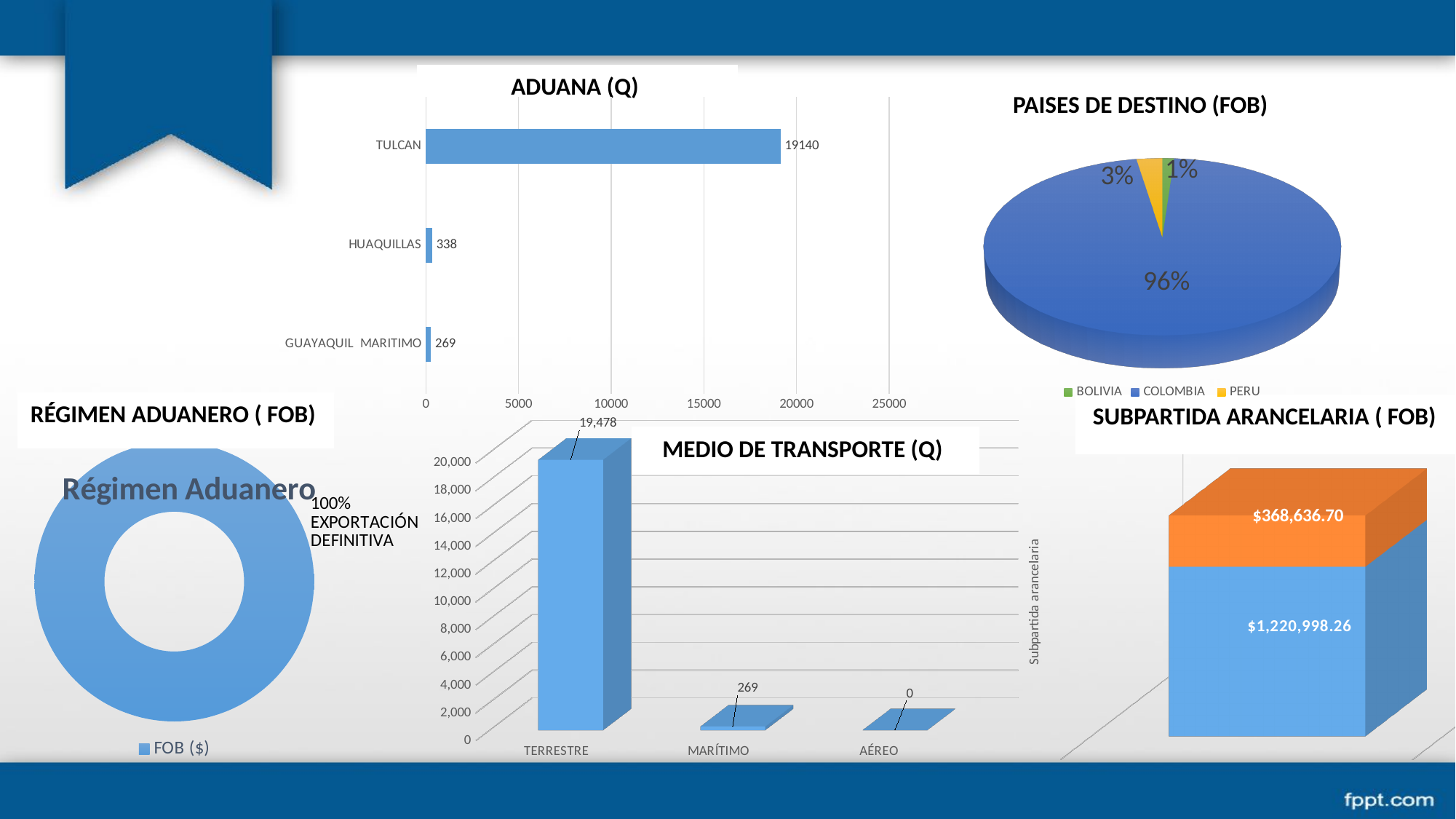
In the PAISES DE DESTINO (FOB) chart, what share does COLOMBIA have? 96% In the ADUANA (Q) chart, what is the difference between the values for TULCAN and HUAQUILLAS? 18802 In the ADUANA (Q) chart, how many categories are shown? 3 In the PAISES DE DESTINO (FOB) chart, how many entries does the legend list? 3 In the MEDIO DE TRANSPORTE (Q) chart, which is larger, MARÍTIMO or AÉREO? MARÍTIMO In the ADUANA (Q) chart, which category has the lowest value? GUAYAQUIL MARITIMO In the SUBPARTIDA ARANCELARIA (FOB) chart, what is the total of the stacked bar? $1,589,634.96 In the ADUANA (Q) chart, what is the value for TULCAN? 19140 In the MEDIO DE TRANSPORTE (Q) chart, what is the value for AÉREO? 0 In the PAISES DE DESTINO (FOB) chart, what share does PERU have? 3% In the MEDIO DE TRANSPORTE (Q) chart, what is the value for TERRESTRE? 19,478 In the RÉGIMEN ADUANERO (FOB) chart, what share does EXPORTACIÓN DEFINITIVA have? 100%